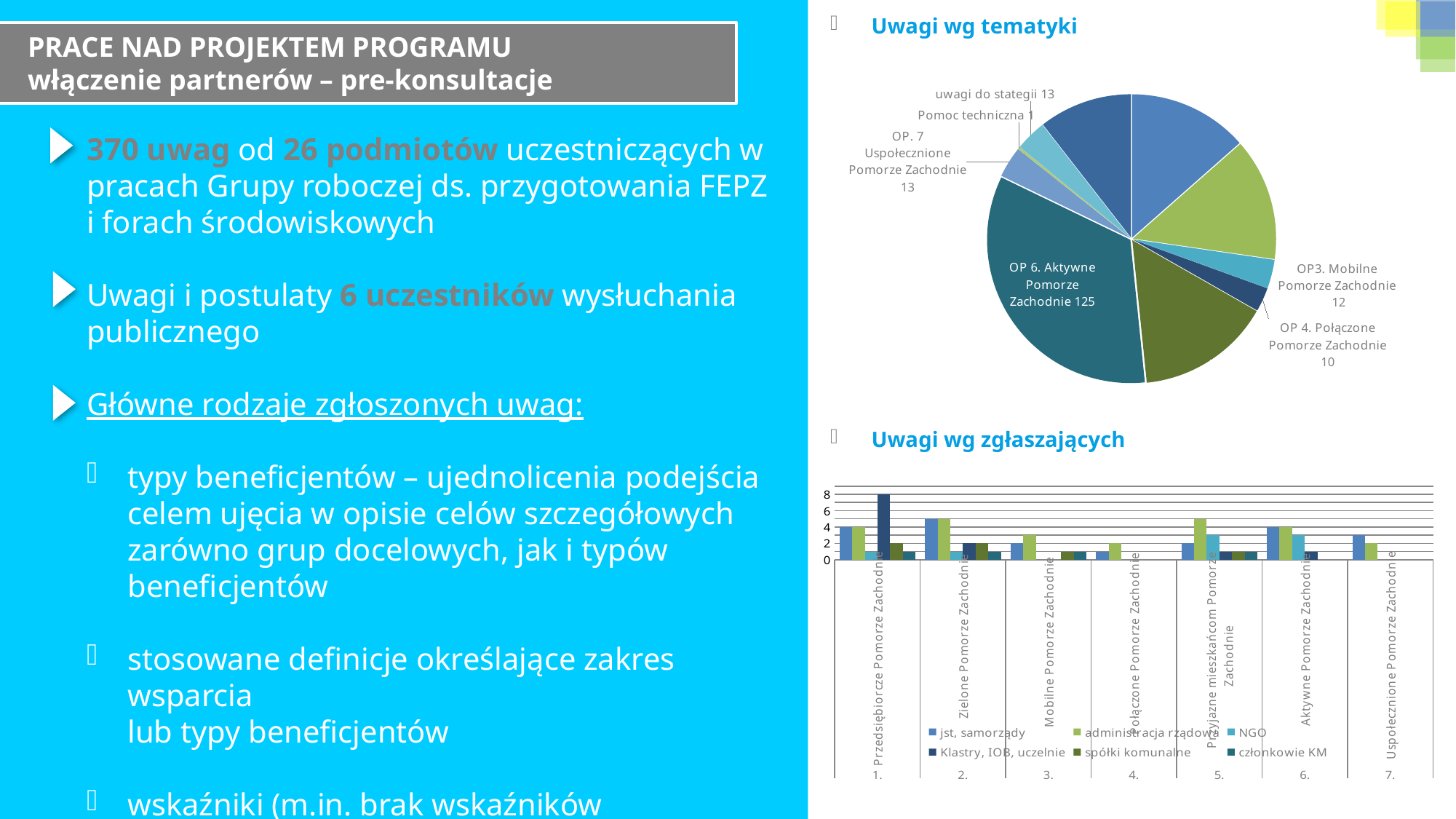
In the pie chart 'Uwagi wg tematyki', what is the difference between OP3. Mobilne Pomorze Zachodnie and OP 4. Połączone Pomorze Zachodnie? 2 In the pie chart 'Uwagi wg tematyki', what is the value for OP 4. Połączone Pomorze Zachodnie? 10 In the pie chart 'Uwagi wg tematyki', which labelled slice has the highest value? OP 6. Aktywne Pomorze Zachodnie In the chart 'Uwagi wg zgłaszających', is the value for jst, samorządy in category 3. Mobilne Pomorze Zachodnie greater or less than 4? less In the pie chart 'Uwagi wg tematyki', what is the value for OP 6. Aktywne Pomorze Zachodnie? 125 In the pie chart 'Uwagi wg tematyki', which is larger: uwagi do stategii or OP3. Mobilne Pomorze Zachodnie? uwagi do stategii What kind of chart is 'Uwagi wg zgłaszających'? bar chart In the chart 'Uwagi wg zgłaszających', is the value for Klastry, IOB, uczelnie in category 1. Przedsiębiorcze Pomorze Zachodnie greater or less than 6? greater How many categories are shown on the x axis of the chart 'Uwagi wg zgłaszających'? 7 How many series does the legend of the chart 'Uwagi wg zgłaszających' list? 6 In the pie chart 'Uwagi wg tematyki', what is the value for Pomoc techniczna? 1 What kind of chart is 'Uwagi wg tematyki'? pie chart